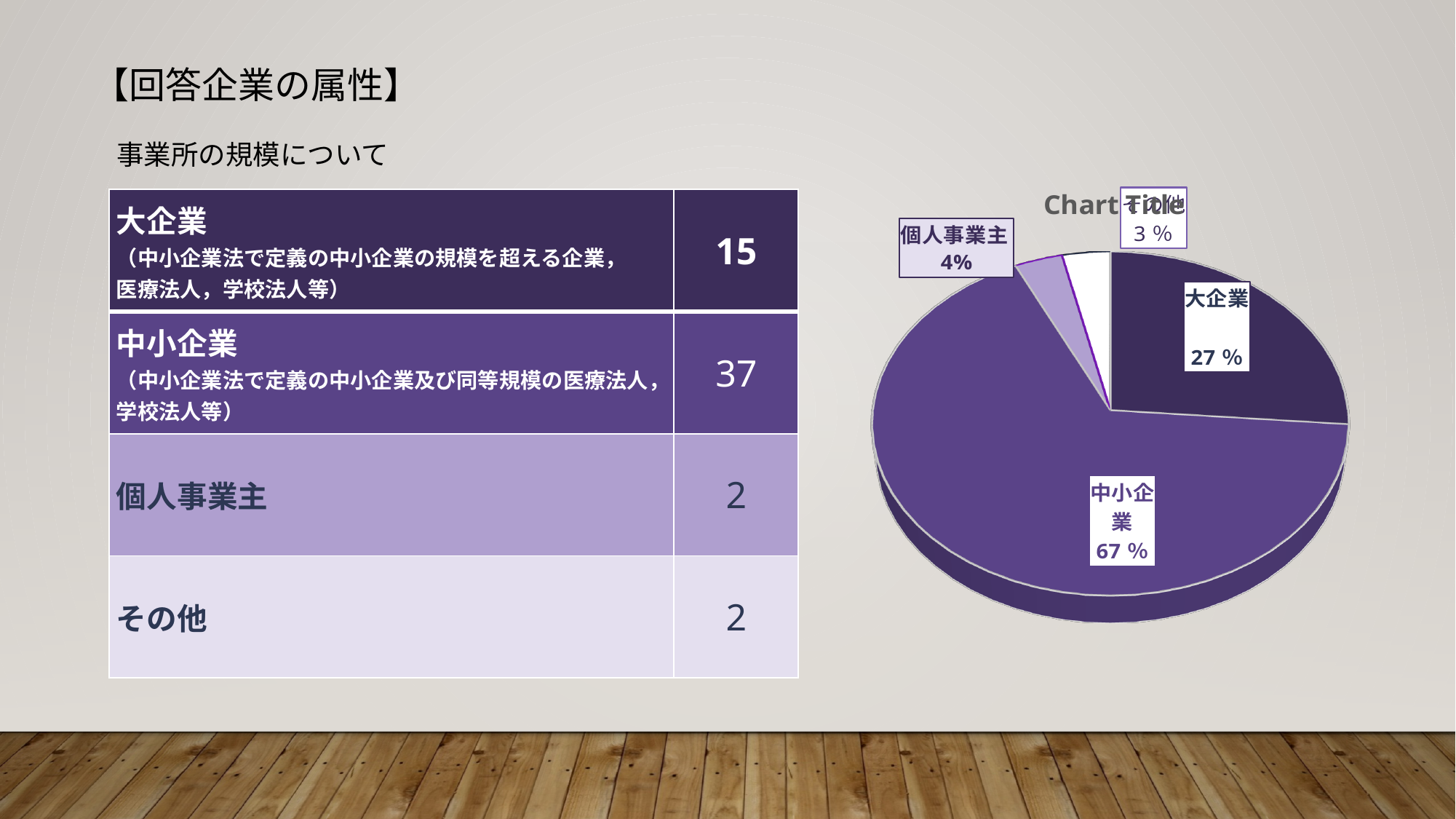
What share of the pie does 個人事業主 hold? 4% What share of the pie does 大企業 hold? 27 % What kind of chart is shown on the slide? pie chart What share of the pie does 中小企業 hold? 67 % What is the difference in percentage points between the 中小企業 slice and the 大企業 slice? 40 How many slices does the pie chart have? 4 Which slice is larger, 大企業 or 個人事業主? 大企業 Which slice of the pie is shown in white? その他 What is the title shown on the pie chart? Chart Title Which category has the largest slice of the pie? 中小企業